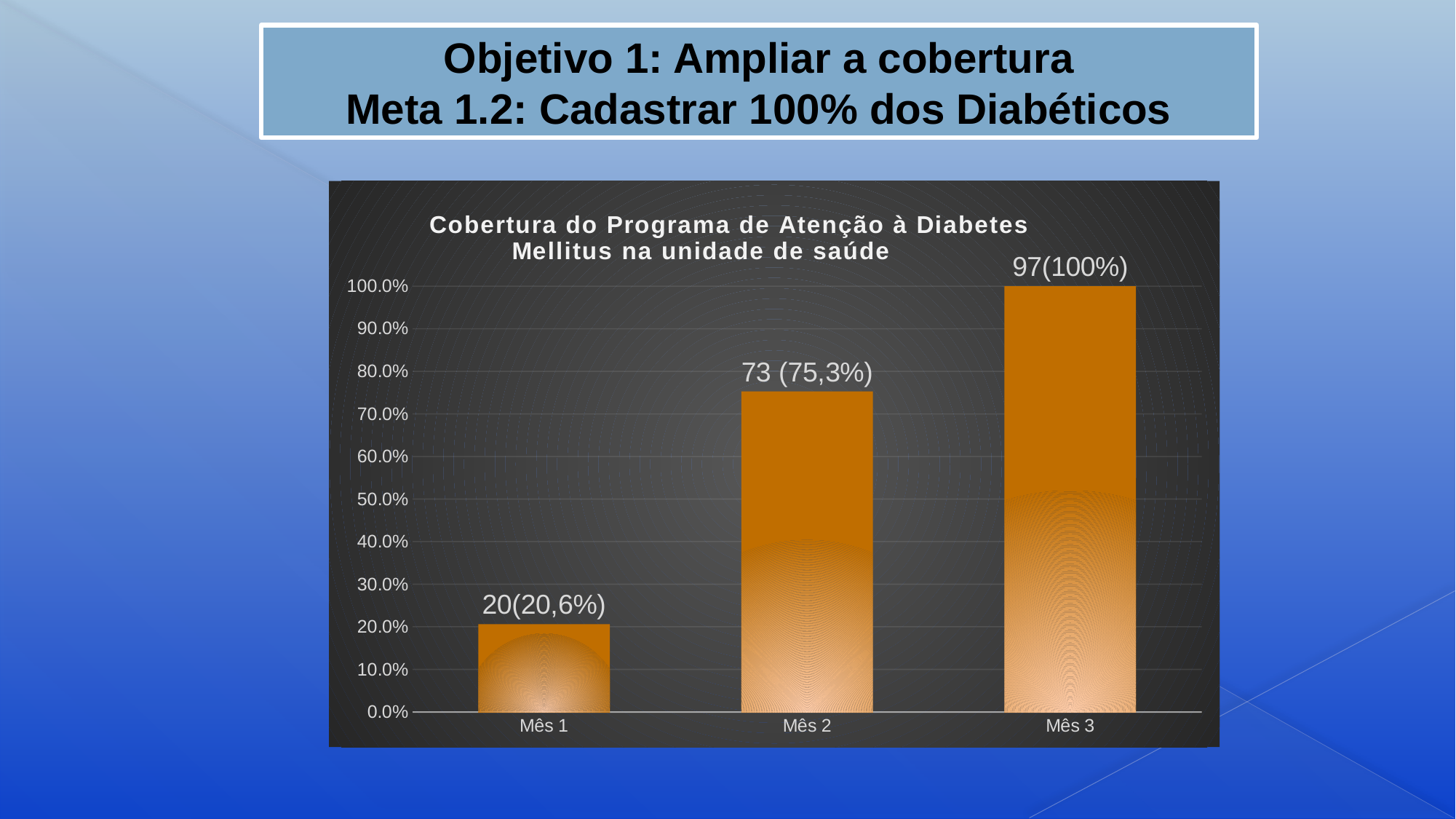
What is the title of the chart? Cobertura do Programa de Atenção à Diabetes Mellitus na unidade de saúde What kind of chart is shown on the slide? Bar chart Is the value for Mês 2 greater or less than 70.0%? greater How many months are shown on the x axis? 3 What is the data label shown for Mês 1? 20(20,6%) Is the value for Mês 1 greater or less than 30.0%? less Which month has the lowest coverage? Mês 1 What is the data label shown for Mês 3? 97(100%) Do the values rise or fall from Mês 1 to Mês 3? Rise What is the data label shown for Mês 2? 73 (75,3%) Which month has the highest coverage? Mês 3 Which is larger, the value for Mês 1 or the value for Mês 2? Mês 2